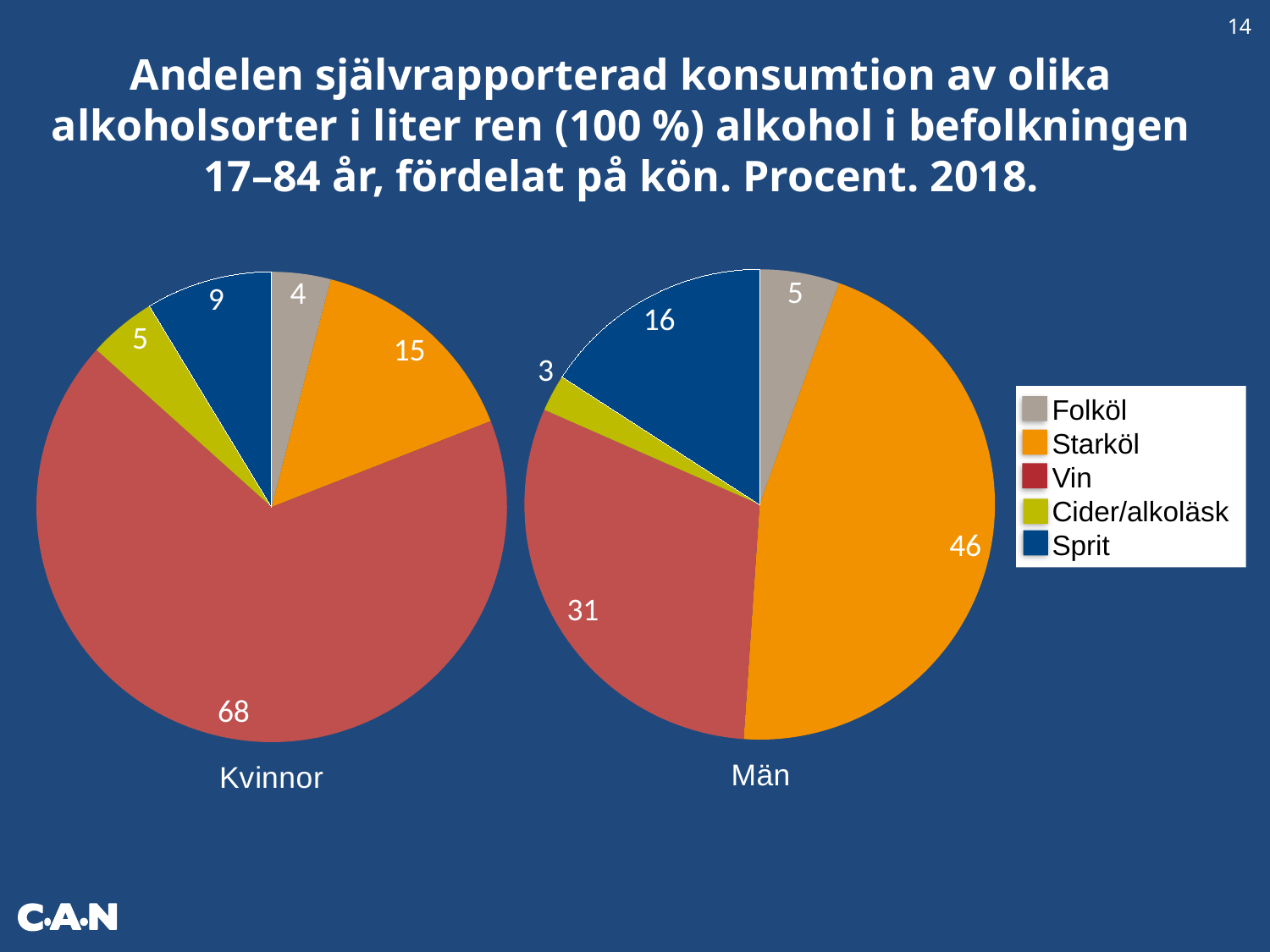
In the Män pie chart, what is the value for Starköl? 46 In the Kvinnor pie chart, which category has the smallest slice? Folköl How many entries does the legend list? 5 In the Kvinnor pie chart, what is the value for Sprit? 9 In the Kvinnor pie chart, which category has the largest slice? Vin In the Kvinnor pie chart, what is the value for Vin? 68 In the Män pie chart, which category has the smallest slice? Cider/alkoläsk How many slices does the Kvinnor pie chart have? 5 What is the difference between the Starköl value in the Män pie chart and the Starköl value in the Kvinnor pie chart? 31 In the Män pie chart, what is the value for Cider/alkoläsk? 3 What kind of chart is used for Kvinnor and Män on this slide? Pie chart In the Män pie chart, which is larger, Vin or Sprit? Vin